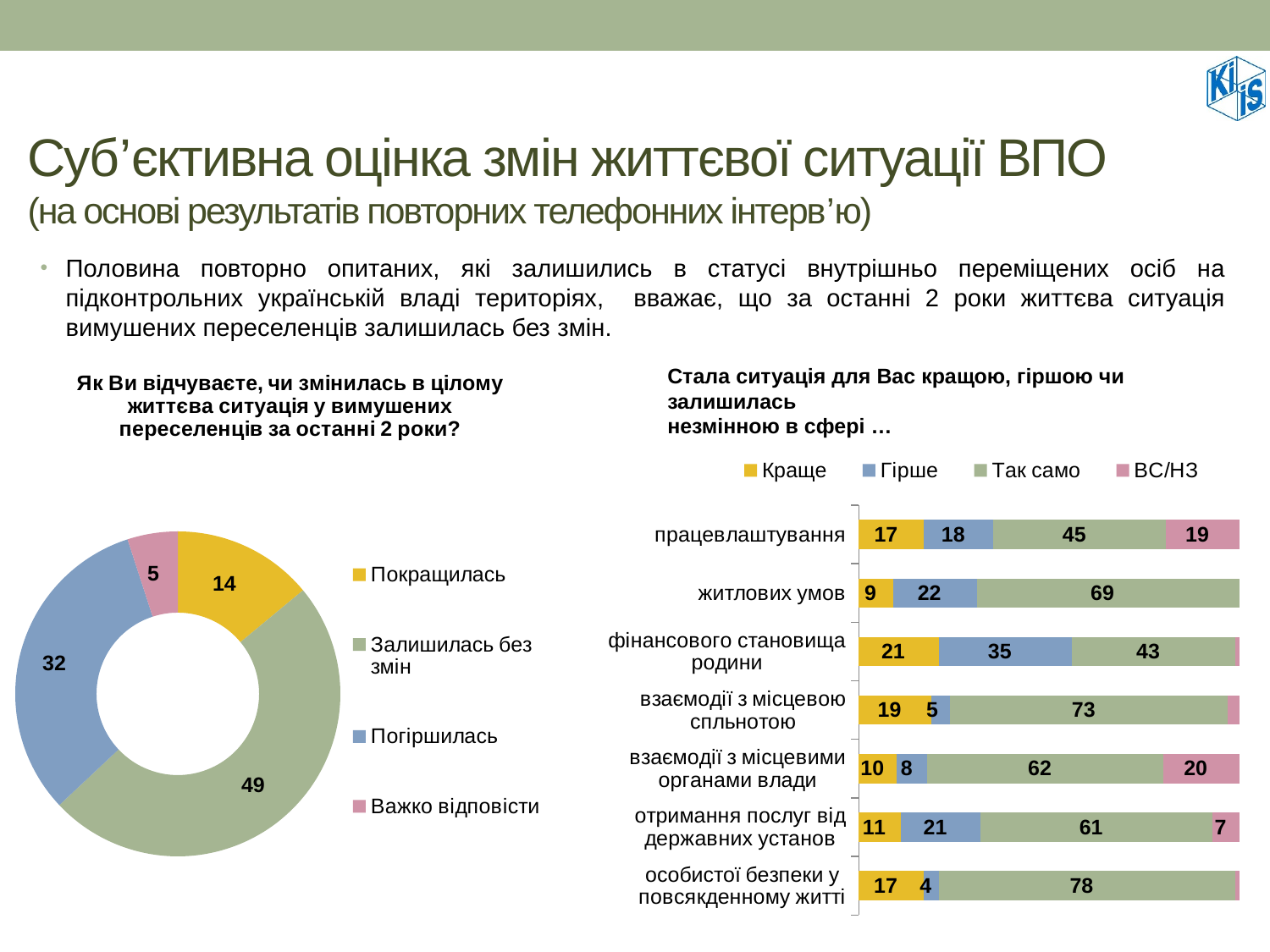
In the right chart, what is the "Гірше" value for "фінансового становища родини"? 35 How many categories are shown in the right chart? 7 In the right chart, which is larger: the "Краще" value for "фінансового становища родини" or for "житлових умов"? фінансового становища родини In the left chart, what is the value for "Погіршилась"? 32 How many series does the legend of the right chart list? 4 In the left chart ("Як Ви відчуваєте, чи змінилась в цілому життєва ситуація..."), what is the value for "Залишилась без змін"? 49 In the left chart, what is the difference between "Залишилась без змін" and "Покращилась"? 35 In the right chart, what is the "ВС/НЗ" value for "взаємодії з місцевими органами влади"? 20 What kind of chart is the left chart? Pie (donut) chart In the right chart ("Стала ситуація для Вас кращою, гіршою чи залишилась незмінною в сфері …"), what is the "Так само" value for "працевлаштування"? 45 In the right chart, which category has the highest "Так само" value? особистої безпеки у повсякденному житті In the left chart, which category has the smallest value? Важко відповісти